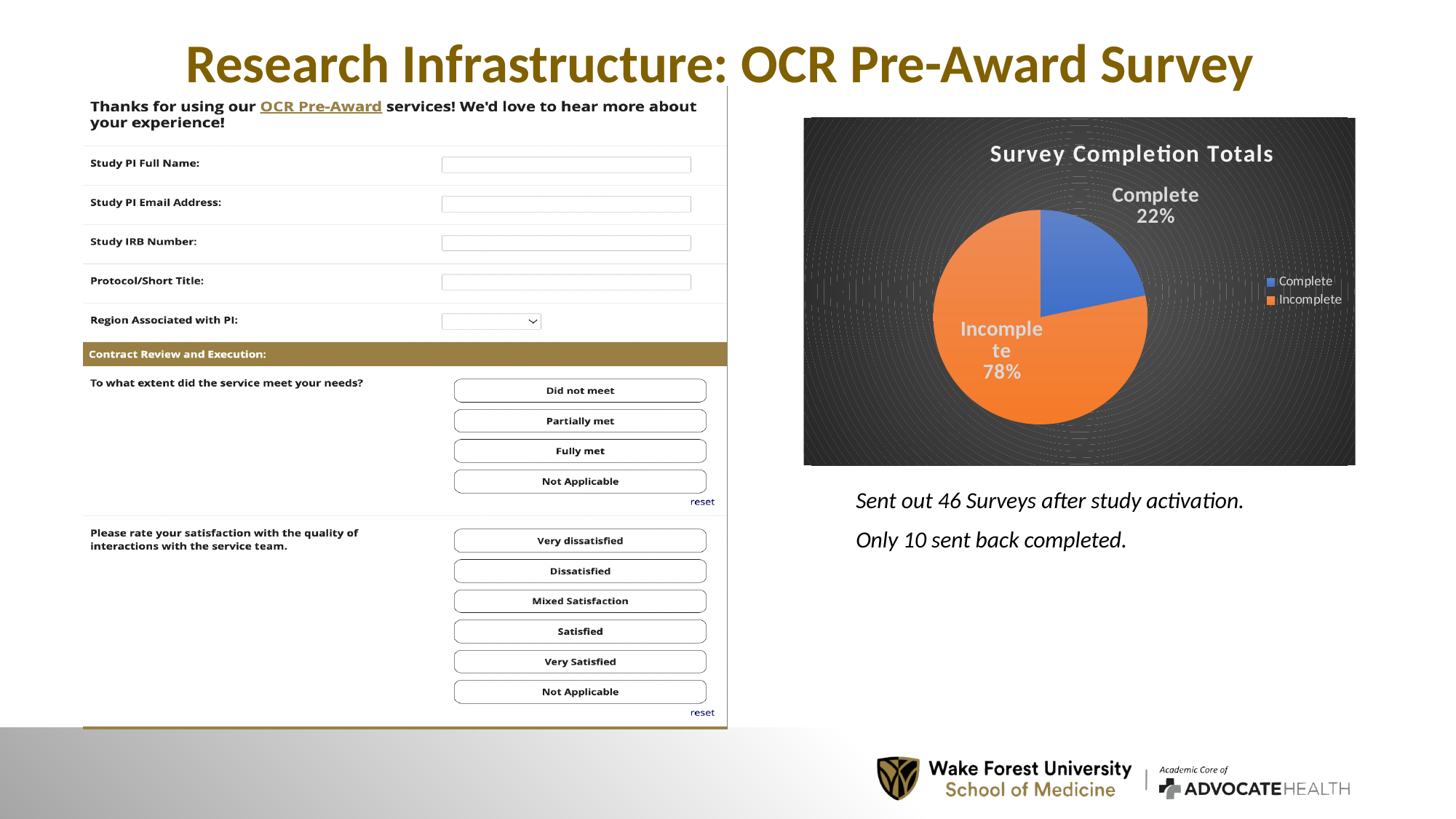
Which slice of the pie is the smallest? Complete Which slice of the pie is the largest? Incomplete What percentage of surveys were Incomplete? 78% How many entries does the legend list? 2 What is the difference in percentage points between the Incomplete and Complete slices? 56 Which is larger, the Complete slice or the Incomplete slice? Incomplete What kind of chart is shown on the slide? pie chart How many slices does the pie chart have? 2 What percentage of surveys were Complete? 22% What is the title of the chart? Survey Completion Totals What colour is the Incomplete slice? orange Is the share for Complete greater or less than 50%? less